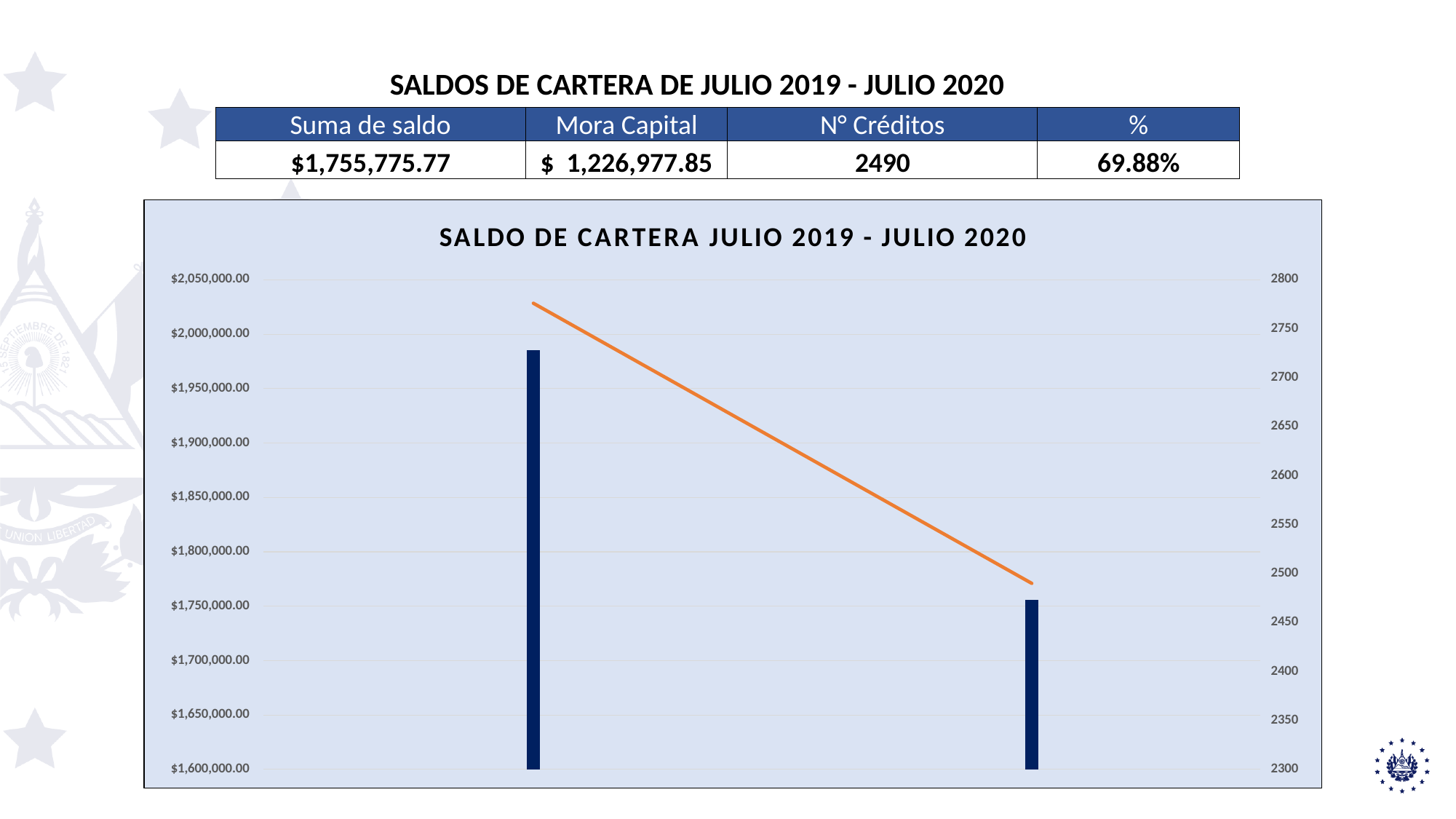
What is the highest value shown on the left vertical axis? $2,050,000.00 What kind of chart is shown on the slide? A bar chart combined with a line What is the title of the chart? SALDO DE CARTERA JULIO 2019 - JULIO 2020 What is the lowest value shown on the right vertical axis? 2300 On the right axis, is the starting value of the orange line greater or less than 2750? greater Is the value of the right bar greater or less than $1,800,000.00? less Does the orange line rise or fall from left to right? Fall Is the value of the left bar greater or less than $1,950,000.00? greater How many bars are plotted in the chart? 2 Do the bar values rise or fall from left to right? Fall Which bar is taller, the left bar or the right bar? The left bar